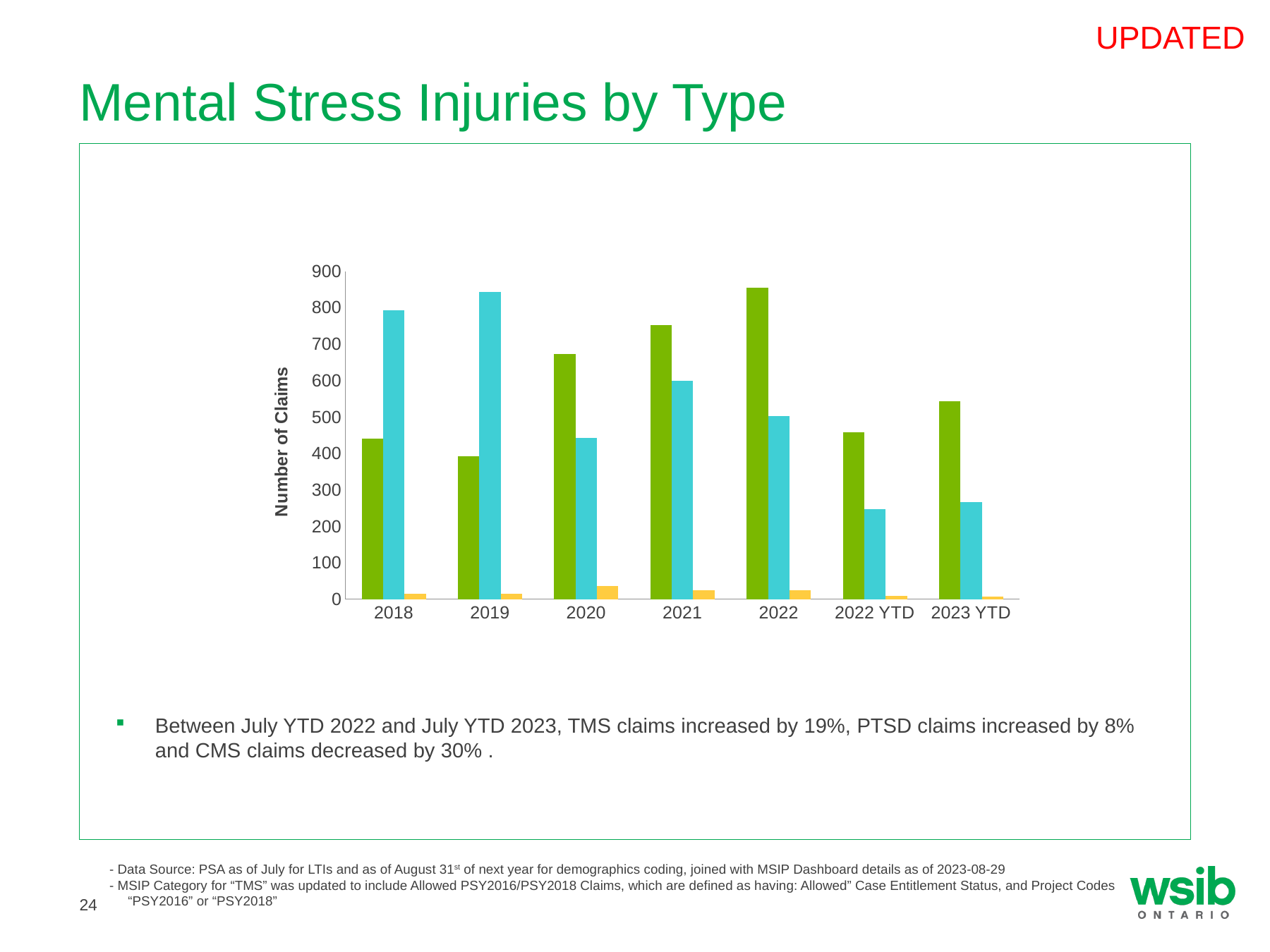
What kind of chart is shown on the slide? bar chart In which category is the cyan bar the tallest? 2019 How many bars (series) are plotted for each year category in the chart? 3 Is the value of the cyan bar for 2022 YTD greater or less than 300? less How many categories are shown on the x axis of the chart? 7 What is the label of the vertical axis of the chart? Number of Claims In which category is the green bar the shortest? 2019 For 2018, which is larger: the green bar or the cyan bar? the cyan bar Is the value of the cyan bar for 2018 greater or less than 700? greater For 2021, which is larger: the green bar or the cyan bar? the green bar In which category is the green bar the tallest? 2022 Is the value of the green bar for 2022 greater or less than 800? greater